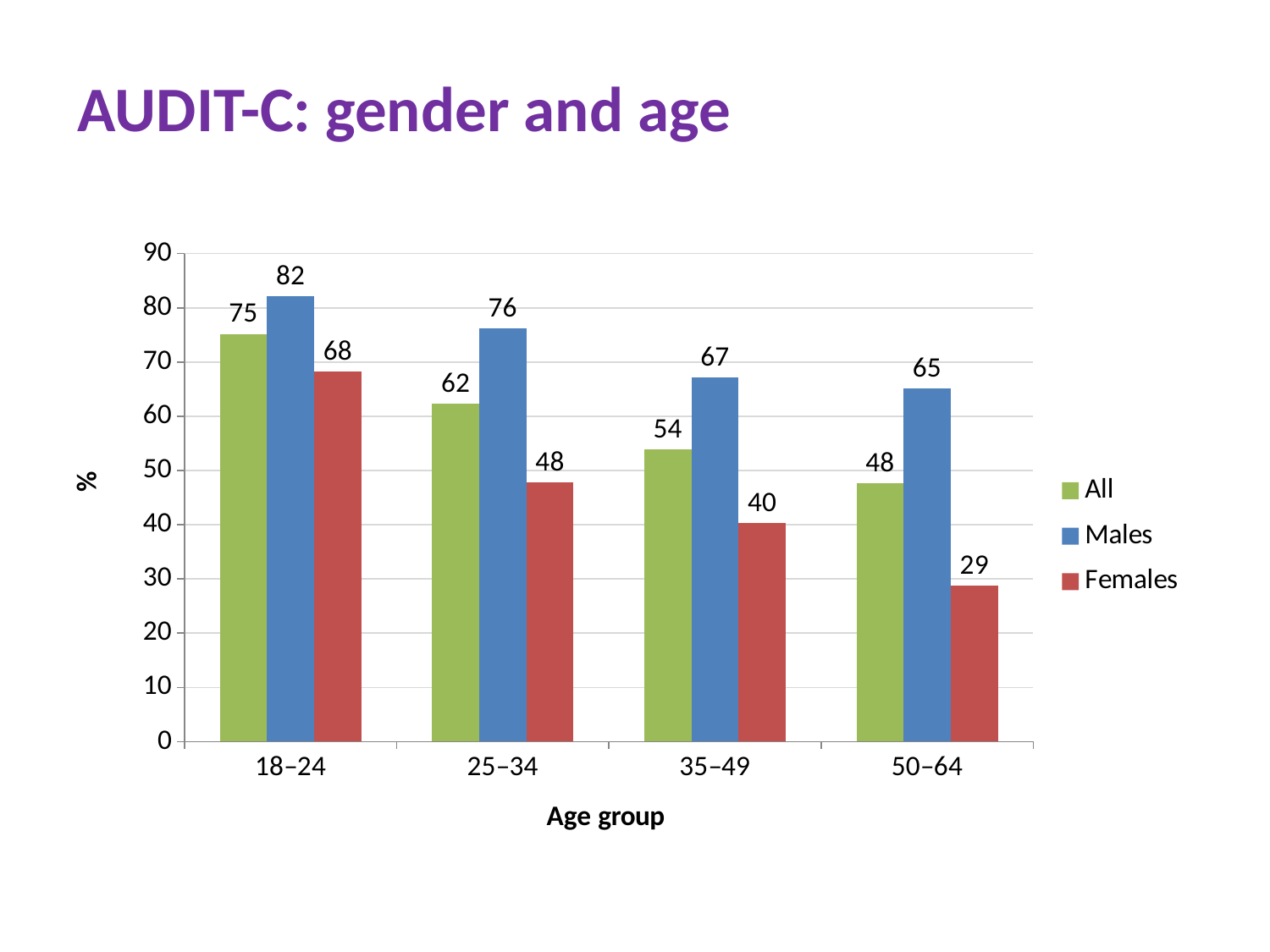
What is the label of the x axis? Age group Which is larger: the All value for 25–34 or the Males value for 50–64? Males value for 50–64 Which age group has the highest value for Females? 18–24 Do the Females values rise or fall as age group increases along the x axis? Fall What kind of chart is shown on the slide? Bar chart What is the value for Males in the 18–24 age group? 82 What is the value for All in the 35–49 age group? 54 What is the value for Females in the 50–64 age group? 29 Which age group has the lowest value for Males? 50–64 What is the difference between the Males and Females values in the 25–34 age group? 28 How many series does the legend list? 3 How many age groups are shown on the x axis? 4